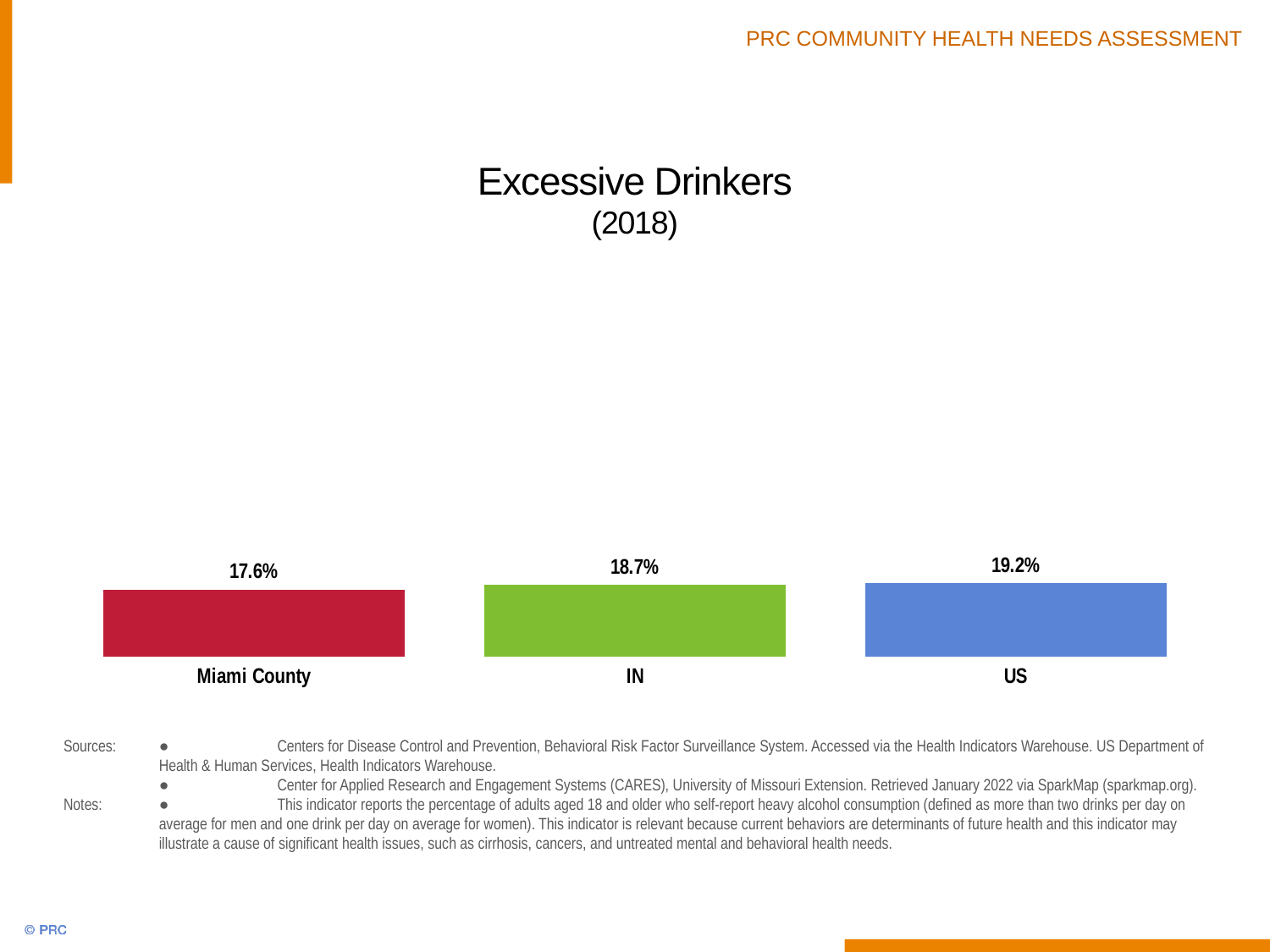
Do the values rise or fall from left to right across the categories? rise What is the value for IN? 18.7% Which category has the highest value? US What is the title of the chart? Excessive Drinkers (2018) Which is larger, the value for IN or the value for US? US Which category has the lowest value? Miami County What kind of chart is shown on the slide? bar chart What is the value for Miami County? 17.6% How many categories are shown in the chart? 3 What is the difference between the US value and the Miami County value? 1.6% What is the difference between the IN value and the Miami County value? 1.1% What is the value for US? 19.2%